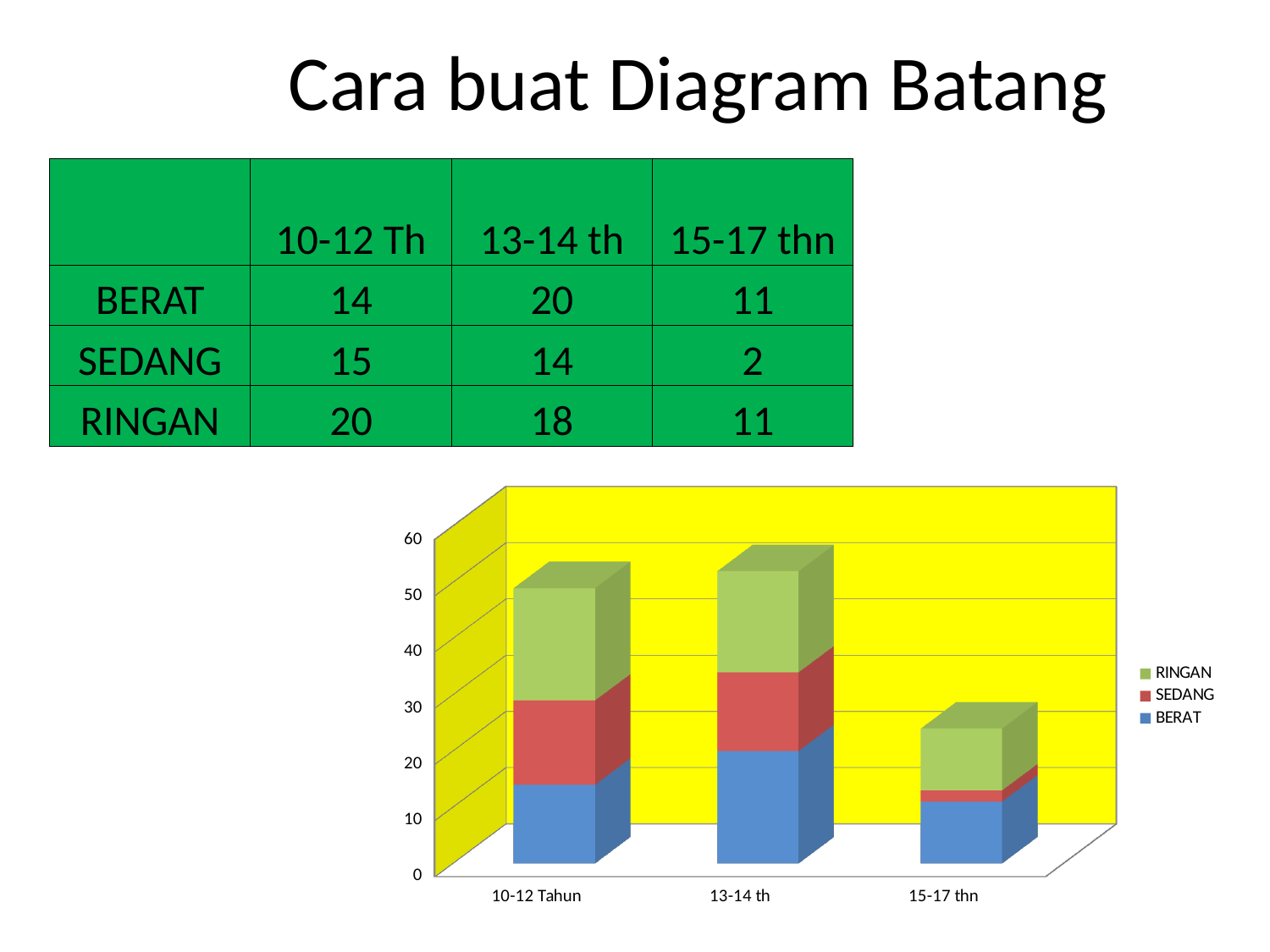
Which age group has the shortest stacked bar in the chart? 15-17 thn What is the difference between the BERAT values for 13-14 th and 15-17 thn? 9 What is the BERAT value for the 13-14 th group? 20 What is the RINGAN value for the 10-12 Tahun group? 20 What kind of chart is shown on the slide? stacked bar chart Which age group has the tallest stacked bar in the chart? 13-14 th What is the total of the stacked bar for the 13-14 th group? 52 How many age-group categories are shown on the x axis of the chart? 3 What is the SEDANG value for the 15-17 thn group? 2 How many series does the chart legend list? 3 Which series is shown in green in the chart? RINGAN Is the total stacked bar for 15-17 thn greater or less than 30? less